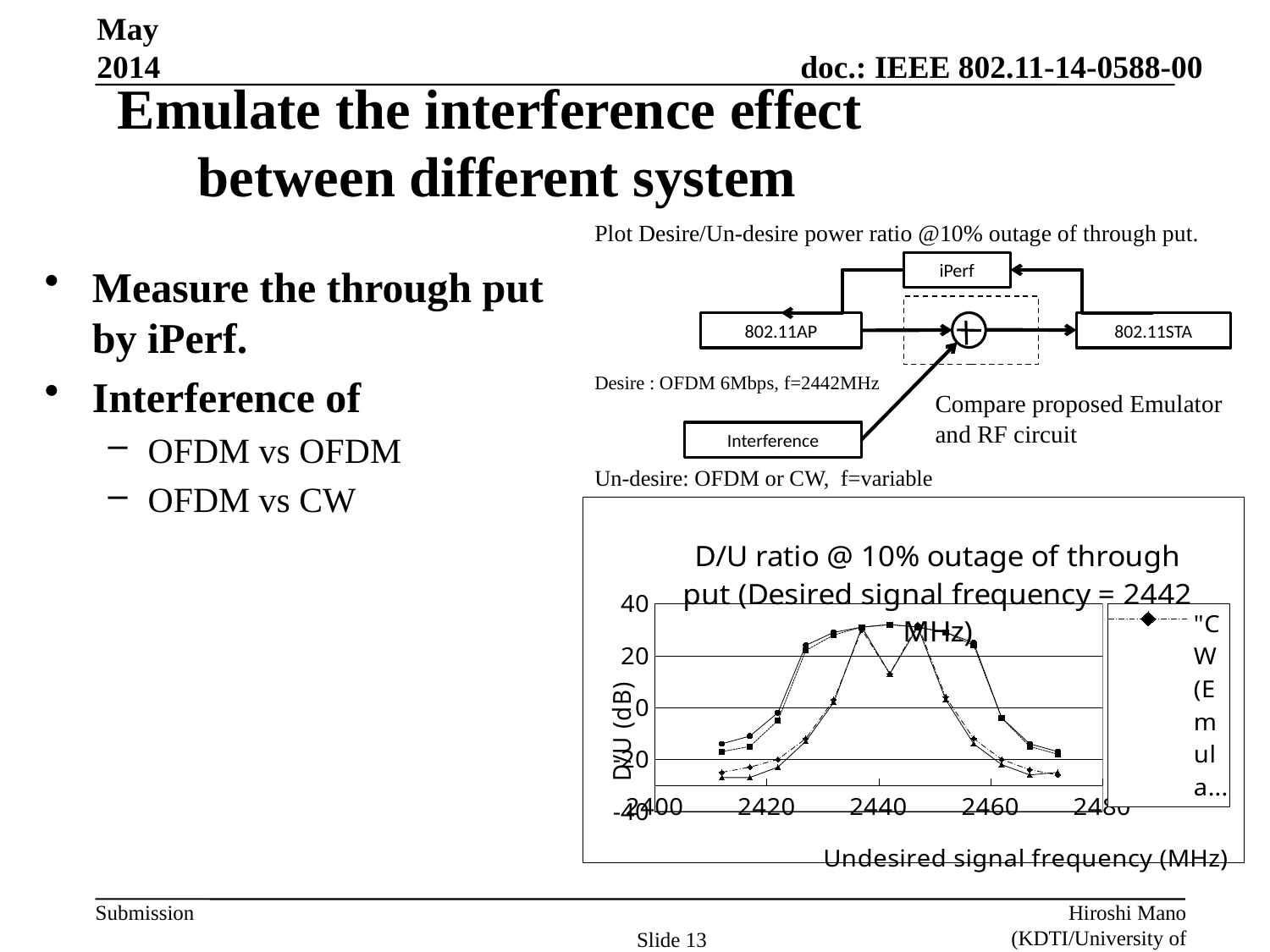
Is the lowest plotted D/U value on the chart greater or less than -20? less What is the label of the x axis of the chart? Undesired signal frequency (MHz) What is the highest tick value shown on the x axis of the chart? 2480 What desired signal frequency is stated in the chart title? 2442 MHz Is the highest plotted D/U value on the chart greater or less than 40? less What kind of chart is shown on the slide? line chart Is the highest plotted D/U value on the chart greater or less than 20? greater How many tick labels are shown on the x axis of the chart? 5 What is the title of the chart on the slide? D/U ratio @ 10% outage of through put (Desired signal frequency = 2442 MHz) What is the lowest tick value shown on the y axis of the chart? -40